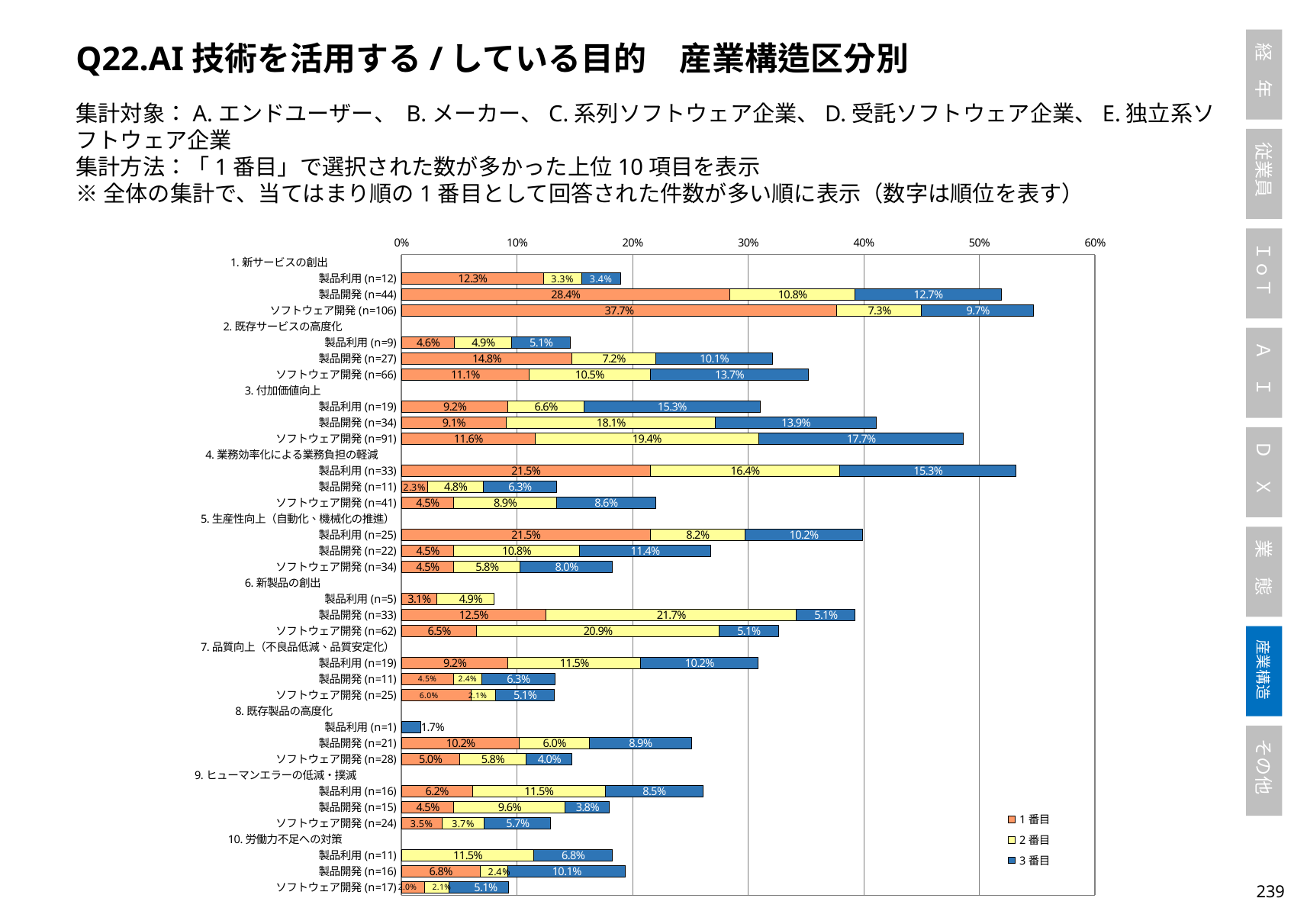
What is the 2番目 value for 製品利用 (n=33) under 4. 業務効率化による業務負担の軽減? 16.4% Is the total stacked bar for ソフトウェア開発 (n=106) under 1. 新サービスの創出 greater or less than 50%? greater Under 3. 付加価値向上, which has the larger 3番目 value: 製品利用 (n=19) or 製品開発 (n=34)? 製品利用 (n=19) What is the total of the stacked bar for ソフトウェア開発 (n=91) under 3. 付加価値向上? 48.7% What is the total of the stacked bar for 製品開発 (n=44) under 1. 新サービスの創出? 51.9% Which bar has the highest 1番目 value in the chart? ソフトウェア開発 (n=106) under 1. 新サービスの創出 What is the 1番目 value for ソフトウェア開発 (n=106) under 1. 新サービスの創出? 37.7% How many numbered purpose groups are shown in the chart? 10 What kind of chart is shown on the slide? Stacked horizontal bar chart Under 1. 新サービスの創出, how much larger is the 1番目 value for 製品開発 (n=44) than for 製品利用 (n=12)? 16.1 percentage points What is the 3番目 value for 製品利用 (n=1) under 8. 既存製品の高度化? 1.7% How many series does the legend list? 3